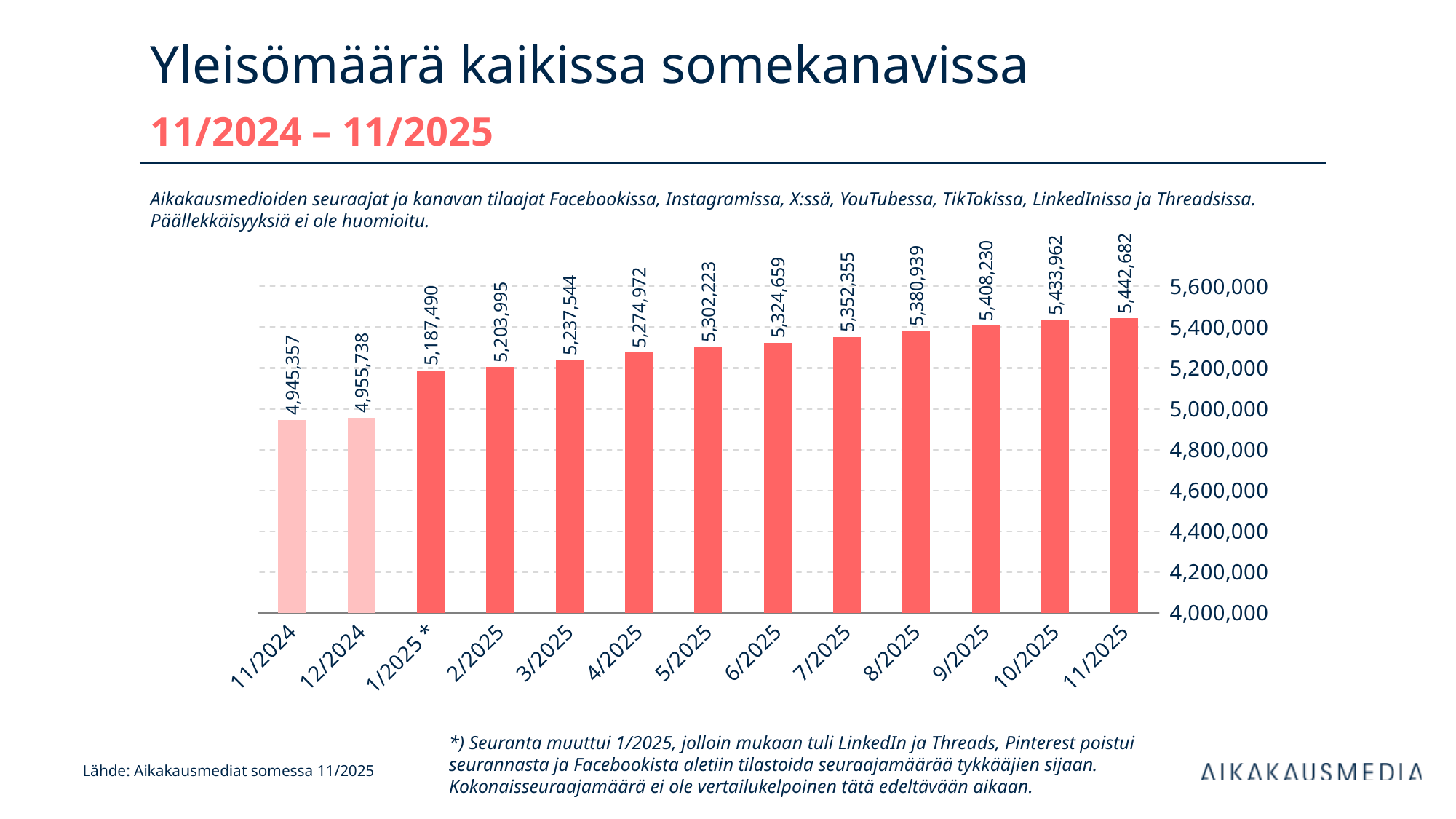
Which is larger, the value for 9/2025 or the value for 3/2025? 9/2025 What is the difference between the values for 1/2025 * and 12/2024? 231,752 What type of chart is shown on the slide? Bar chart Which month has the lowest value? 11/2024 How many months (bars) are shown in the chart? 13 What is the value for 6/2025? 5,324,659 What is the difference between the values for 11/2025 and 11/2024? 497,325 What is the value for 11/2024? 4,945,357 Is the value for 12/2024 greater or less than 5,000,000? less Which month has the highest value? 11/2025 Do the values rise or fall from 11/2024 to 11/2025? Rise What is the value for 11/2025? 5,442,682